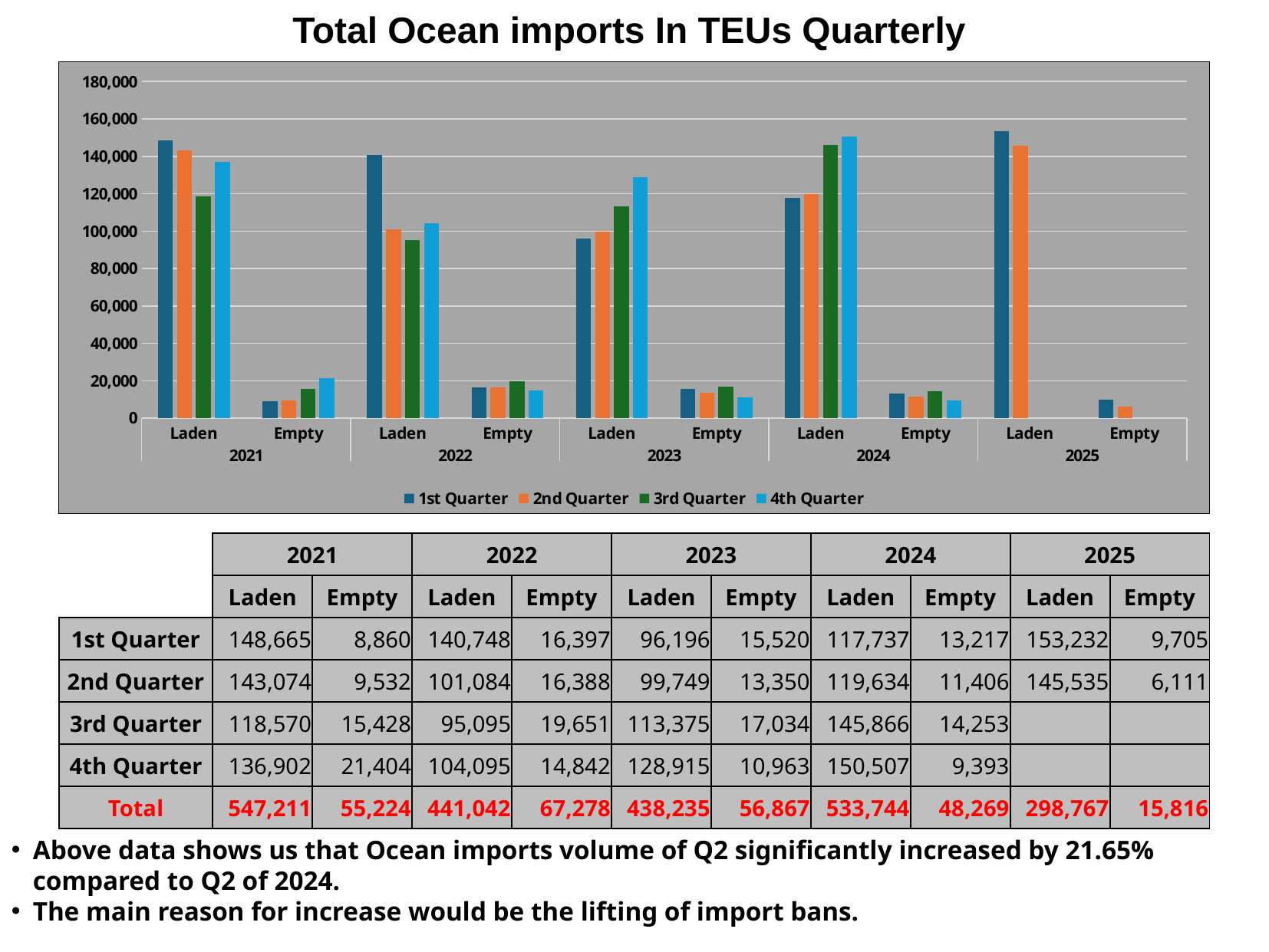
What is the difference between the 2nd Quarter Laden value for 2025 and for 2024? 25,901 For 2021 Laden, which is larger: the 1st Quarter or the 2nd Quarter value? 1st Quarter Which quarter and year has the highest Laden value? 1st Quarter 2025 How many years are shown on the x axis of the chart? 5 How many series does the chart legend list? 4 What kind of chart is shown on the slide? Bar chart What is the 2nd Quarter Empty value for 2025? 6,111 Do the Laden values for 2023 rise or fall from the 1st Quarter to the 4th Quarter? Rise Is the 1st Quarter Laden value for 2023 greater or less than 100,000? less What is the 1st Quarter Laden value for 2021? 148,665 What is the total Laden value for 2024? 533,744 Which quarter and year has the lowest Empty value? 2nd Quarter 2025